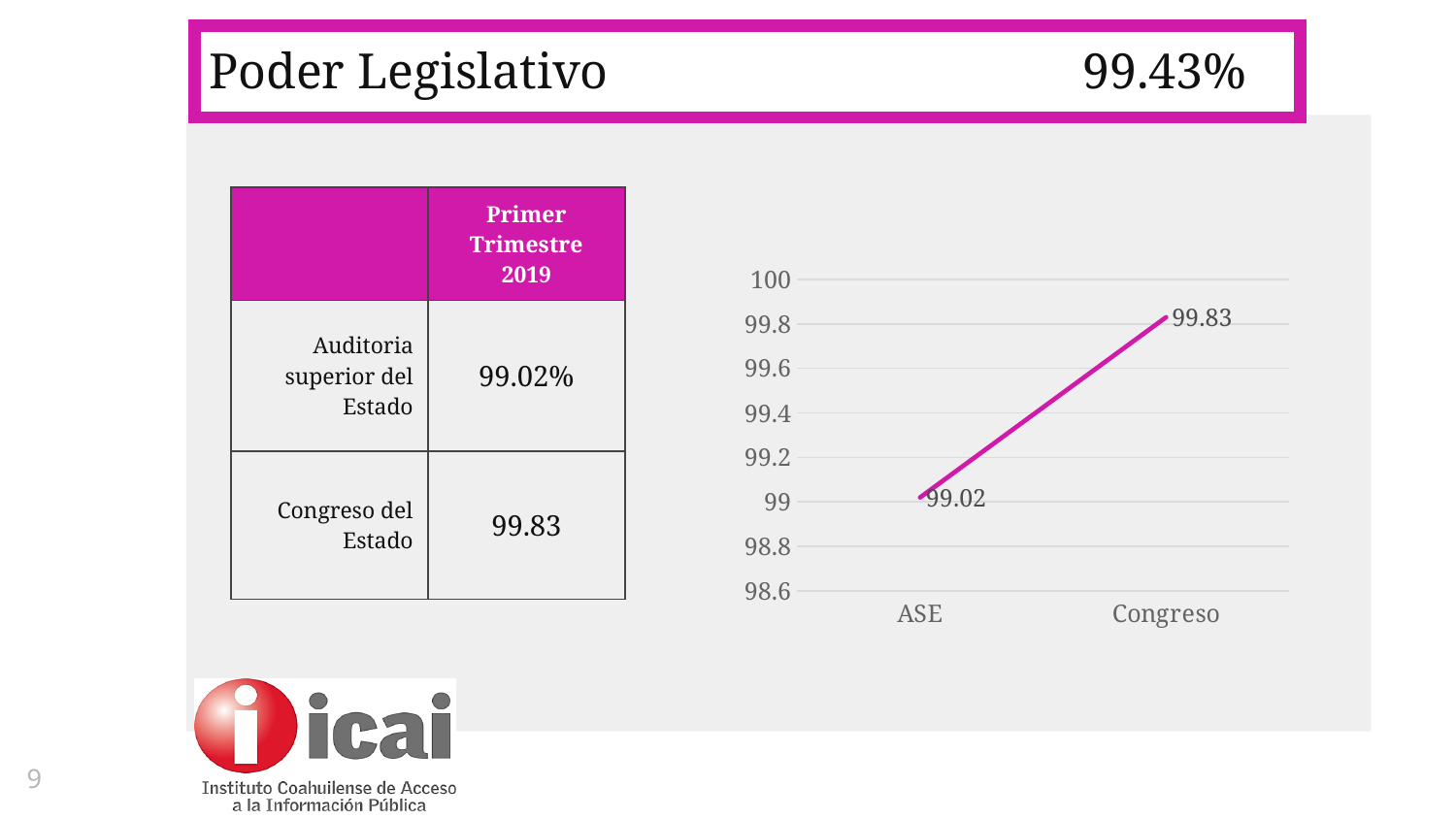
What kind of chart is shown on the slide? line chart Which category has the lowest value in the line chart? ASE Do the values in the line chart rise or fall from ASE to Congreso? rise Which category has the highest value in the line chart? Congreso How many categories are shown on the x axis of the line chart? 2 What is the value plotted for ASE in the line chart? 99.02 Is the value for Congreso in the line chart greater or less than 99.4? greater What colour is the line in the chart? magenta Is the value for ASE in the line chart greater or less than 99.4? less What is the value plotted for Congreso in the line chart? 99.83 What is the difference between the values for Congreso and ASE in the line chart? 0.81 Which is larger in the line chart, the value for ASE or the value for Congreso? Congreso